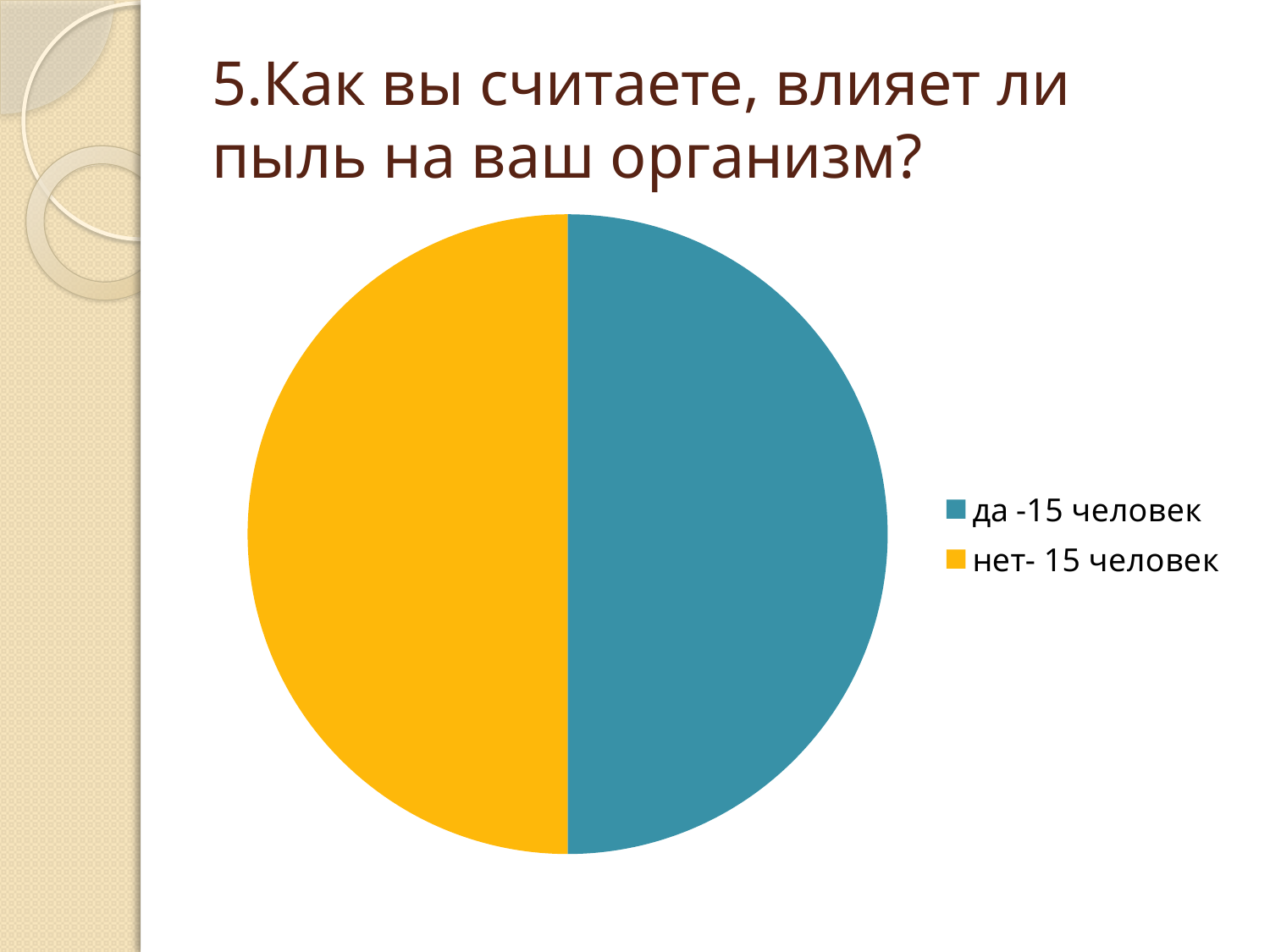
How many slices does the pie chart have? 2 What kind of chart is shown on the slide? pie chart What is the title of the slide above the chart? 5.Как вы считаете, влияет ли пыль на ваш организм? What share of the pie does the "нет" slice represent? 50% What is the total number of people represented in the pie chart? 30 How many people answered "нет" according to the legend? 15 человек How many entries does the legend list? 2 What colour is the slice for "да -15 человек"? blue How many people answered "да" according to the legend? 15 человек What is the difference between the number of people who answered "да" and those who answered "нет"? 0 What share of the pie does the "да" slice represent? 50%